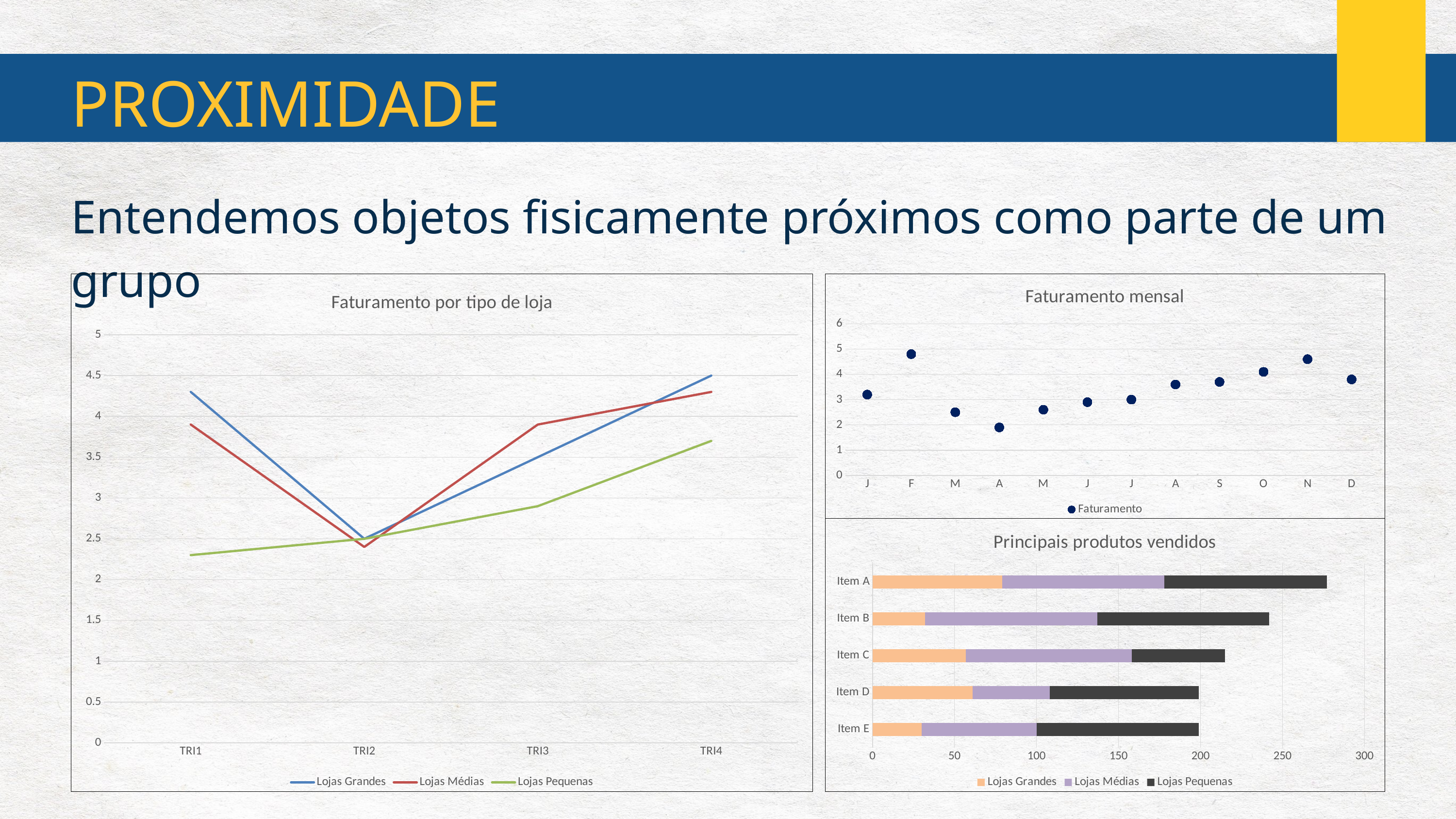
In "Faturamento por tipo de loja", how many series does the legend list? 3 In "Principais produtos vendidos", which item has the longest total bar? Item A What kind of chart is "Faturamento por tipo de loja"? line chart In "Faturamento mensal", how many data points are plotted? 12 In "Principais produtos vendidos", is the total for Item A greater or less than 250? greater What kind of chart is "Principais produtos vendidos"? bar chart In "Faturamento por tipo de loja", do the values for Lojas Pequenas rise or fall from TRI1 to TRI4? rise In "Faturamento mensal", is the value for F greater or less than 4? greater In "Faturamento mensal", which month has the lowest value? A In "Faturamento por tipo de loja", is the value for Lojas Grandes at TRI1 greater or less than 4? greater In "Faturamento por tipo de loja", how many categories are on the x axis? 4 In "Faturamento por tipo de loja", which series is higher at TRI3, Lojas Médias or Lojas Grandes? Lojas Médias